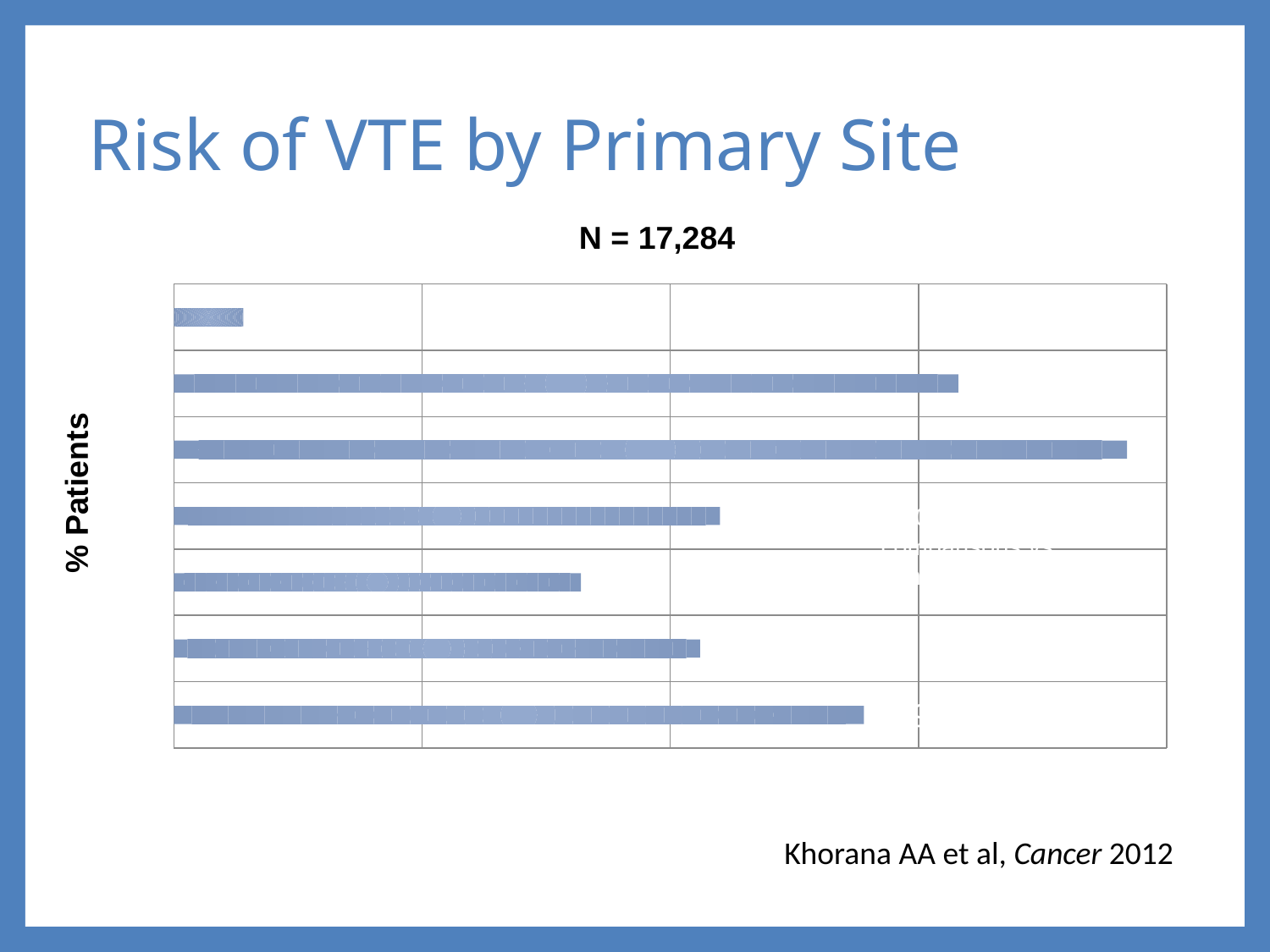
Counting from the top, which bar in the chart is the shortest? the first (top) bar What kind of chart is shown on the slide? bar chart What is the title of the chart on the slide? Risk of VTE by Primary Site How many bars does the chart contain? 7 What label is shown on the vertical axis of the chart? % Patients Is the top bar longer or shorter than the sixth bar from the top? shorter Is the bottom bar longer or shorter than the fifth bar from the top? longer Are the bars in the chart drawn horizontally or vertically? horizontally Is the second bar from the top longer or shorter than the fourth bar from the top? longer Counting from the top, which bar in the chart is the longest? the third bar